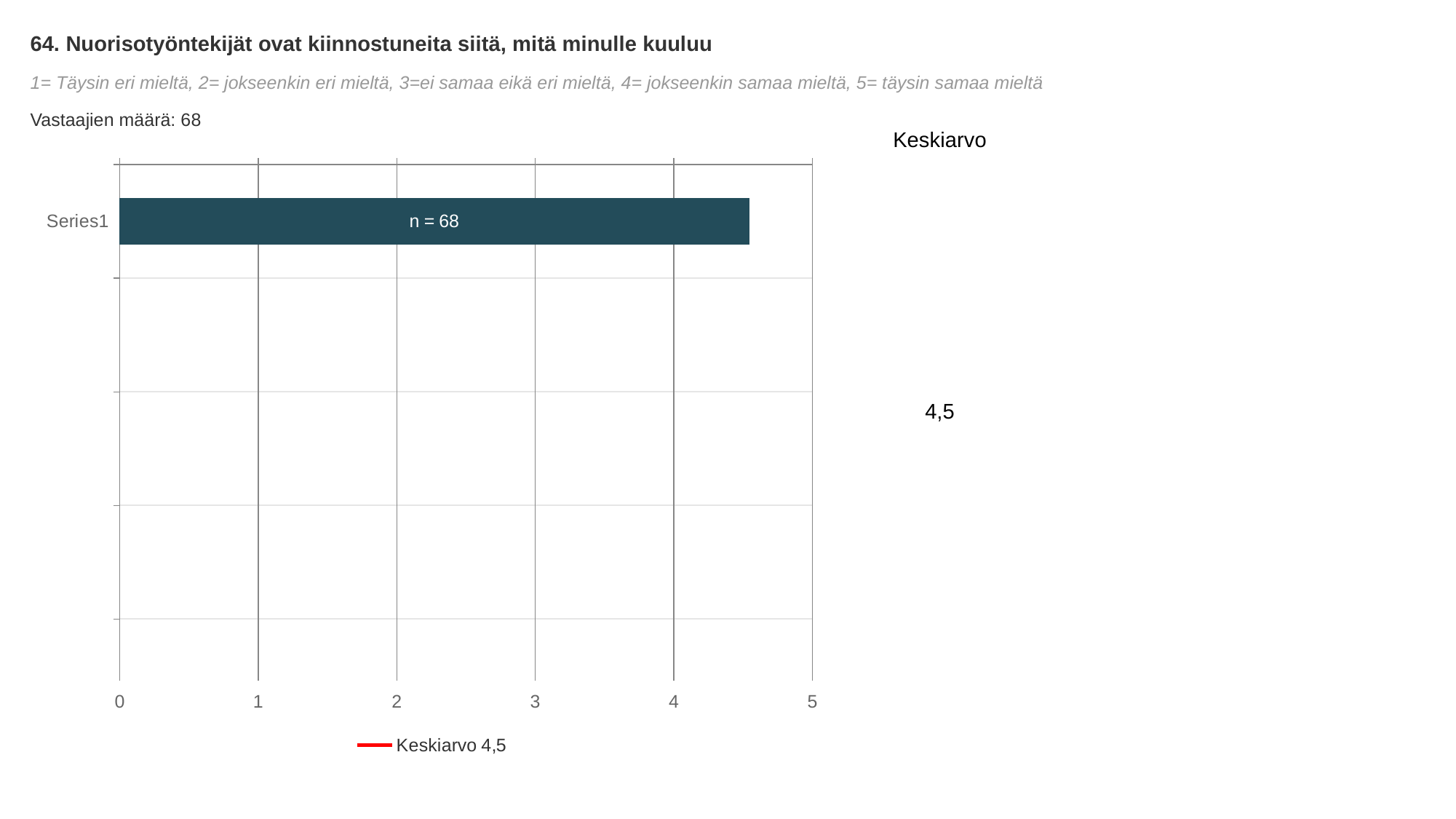
What is the label of the single category on the vertical axis? Series1 What is the highest value shown on the horizontal axis? 5 Is the value of the Series1 bar greater or less than 5? less What is the Keskiarvo (mean) value shown on the slide? 4,5 Is the value of the Series1 bar greater or less than 4? greater How many respondents (Vastaajien määrä) are reported on the slide? 68 What does the legend entry below the chart say? Keskiarvo 4,5 What kind of chart is shown on the slide? bar chart How many bars are plotted in the chart? 1 What data label is printed on the bar? n = 68